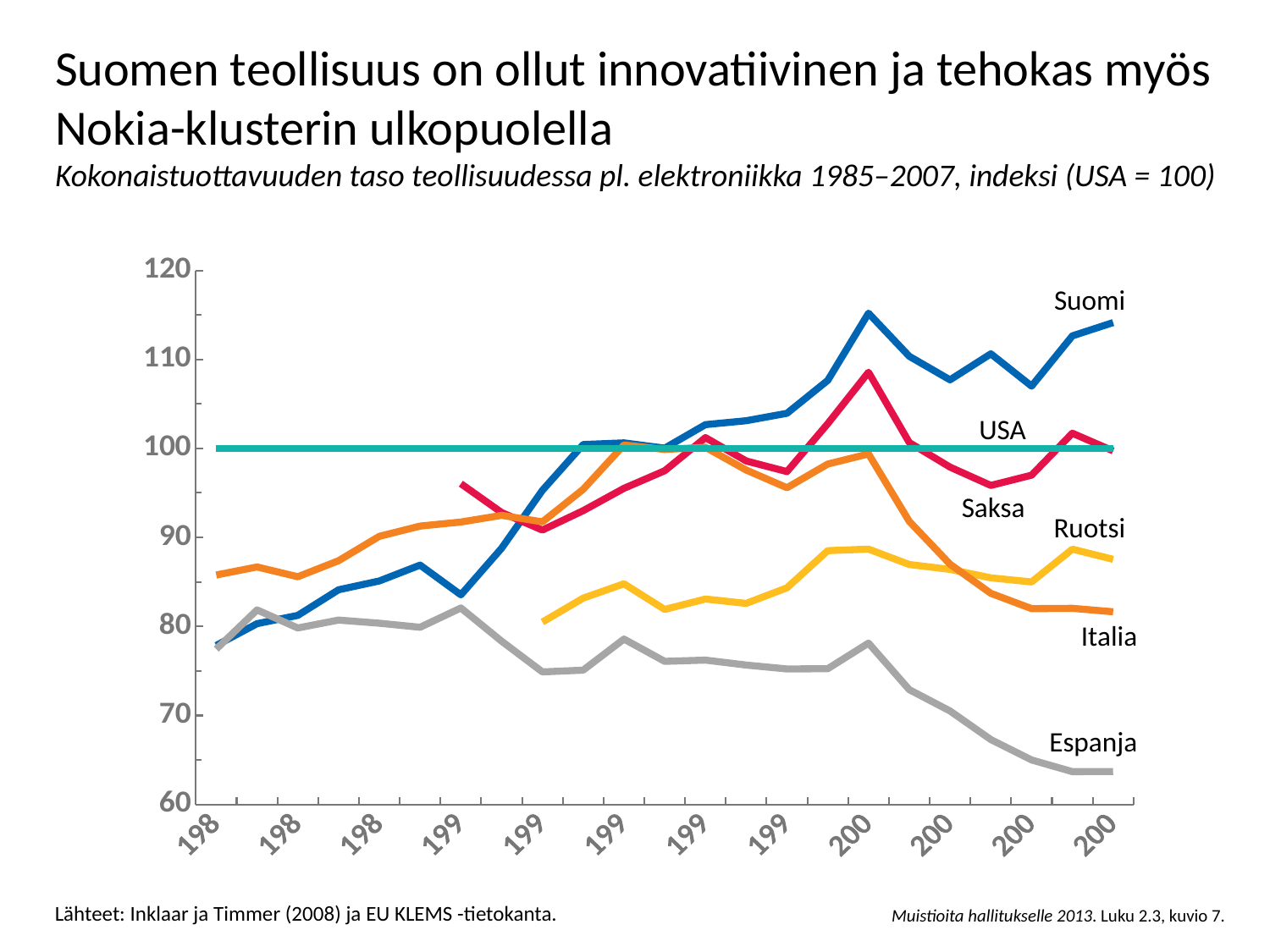
How many country series are labelled on the chart? 6 At the right end of the chart, which is larger, Ruotsi or Italia? Ruotsi What is the value of the USA line throughout the chart? 100 Which series has the highest value at the right end of the chart? Suomi What kind of chart is shown on the slide? line chart Is the value for Italia at the right end of the chart greater or less than 90? less According to the subtitle, which country is set to 100 in the index? USA Does the Espanja line rise or fall overall from left to right? fall At the right end of the chart, which is larger, Espanja or Italia? Italia Which series has the lowest value at the right end of the chart? Espanja Is the value for Espanja at the right end of the chart greater or less than 70? less Is the value for Suomi at the right end of the chart greater or less than 110? greater